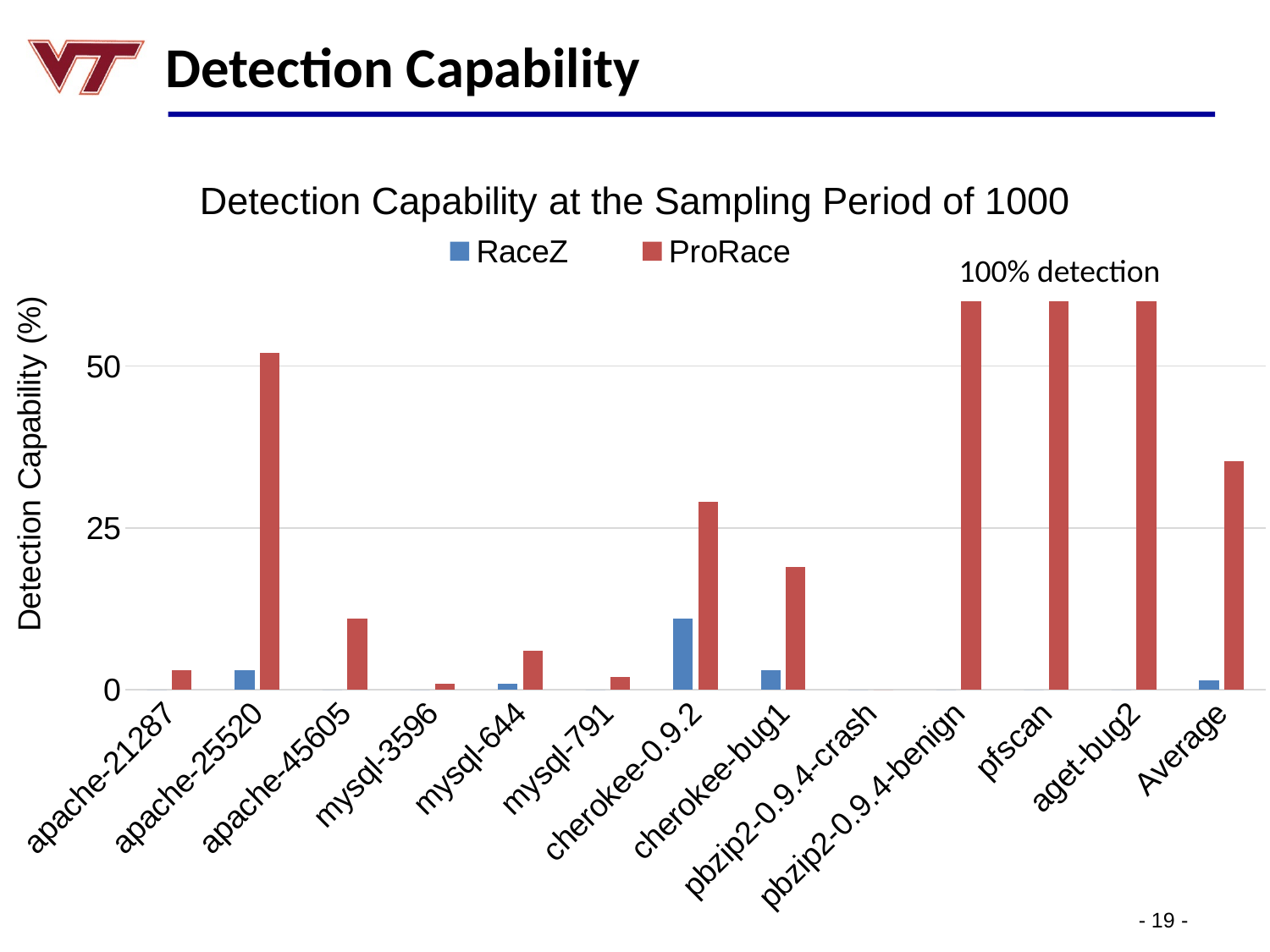
How many categories are shown along the x axis? 13 How many series does the legend list? 2 Is the ProRace value for cherokee-bug1 greater or less than 25? less Which series has the larger value for cherokee-0.9.2, RaceZ or ProRace? ProRace Is the ProRace value for Average greater or less than 25? greater Is the RaceZ value for cherokee-0.9.2 greater or less than 25? less What kind of chart is shown on the slide? bar chart What is the label of the y axis? Detection Capability (%) For apache-25520, which series has the larger value, RaceZ or ProRace? ProRace What is the title of the chart? Detection Capability at the Sampling Period of 1000